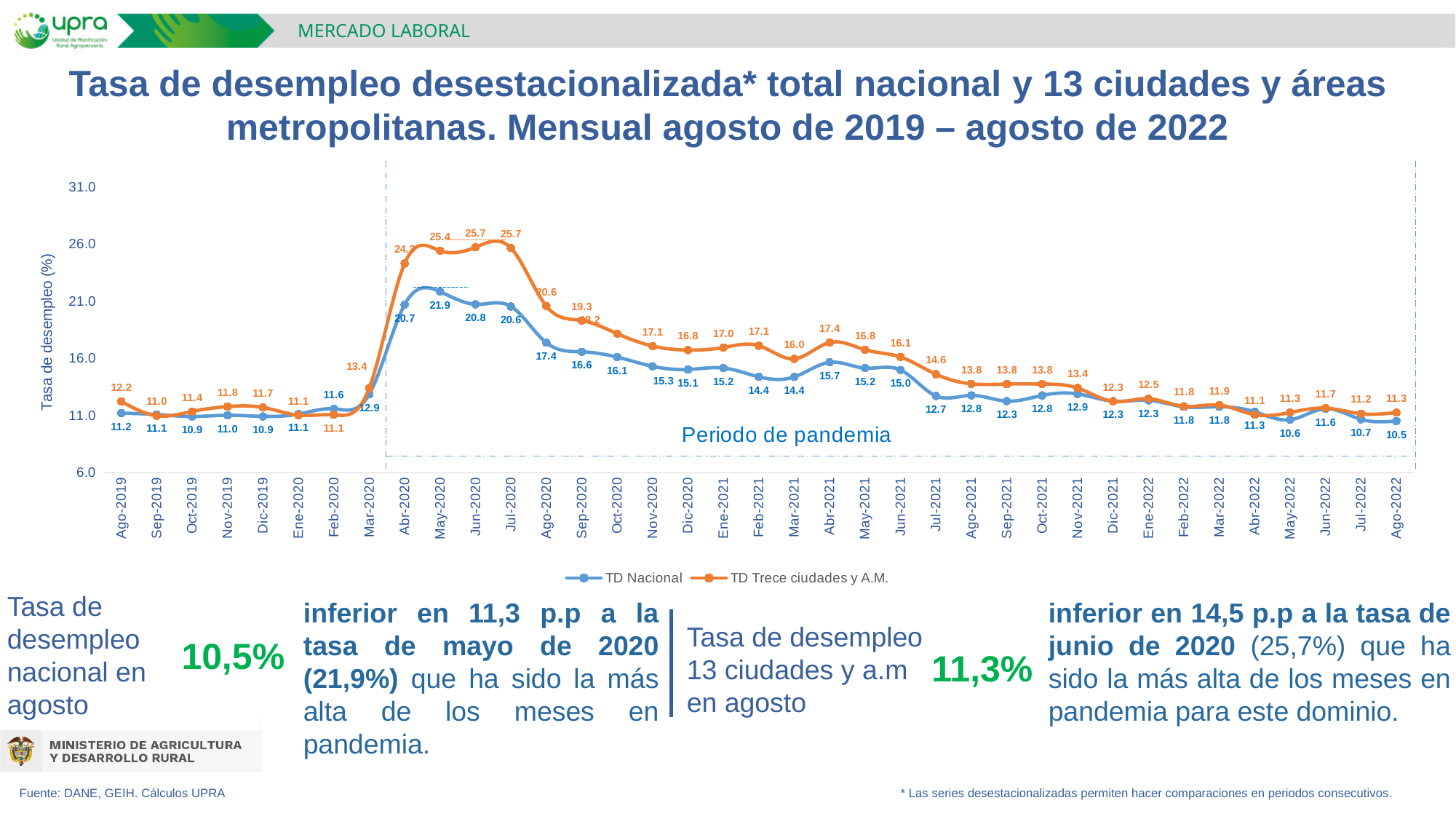
Is the value of TD Trece ciudades y A.M. for Jun-2020 greater or less than 21.0? greater What type of chart is shown on the slide? line chart In which month does TD Nacional reach its highest value? May-2020 What is the value of TD Nacional for Ago-2022? 10.5 How many months are plotted along the x axis? 37 What is the lowest value of TD Nacional shown on the chart? 10.5 What is the difference between TD Trece ciudades y A.M. and TD Nacional in Ago-2022? 0.8 What is the label of the y axis? Tasa de desempleo (%) Which series has the higher value in Jul-2020, TD Nacional or TD Trece ciudades y A.M.? TD Trece ciudades y A.M. How many series does the legend list? 2 What is the value of TD Trece ciudades y A.M. for Ago-2022? 11.3 What is the value of TD Nacional for May-2020? 21.9